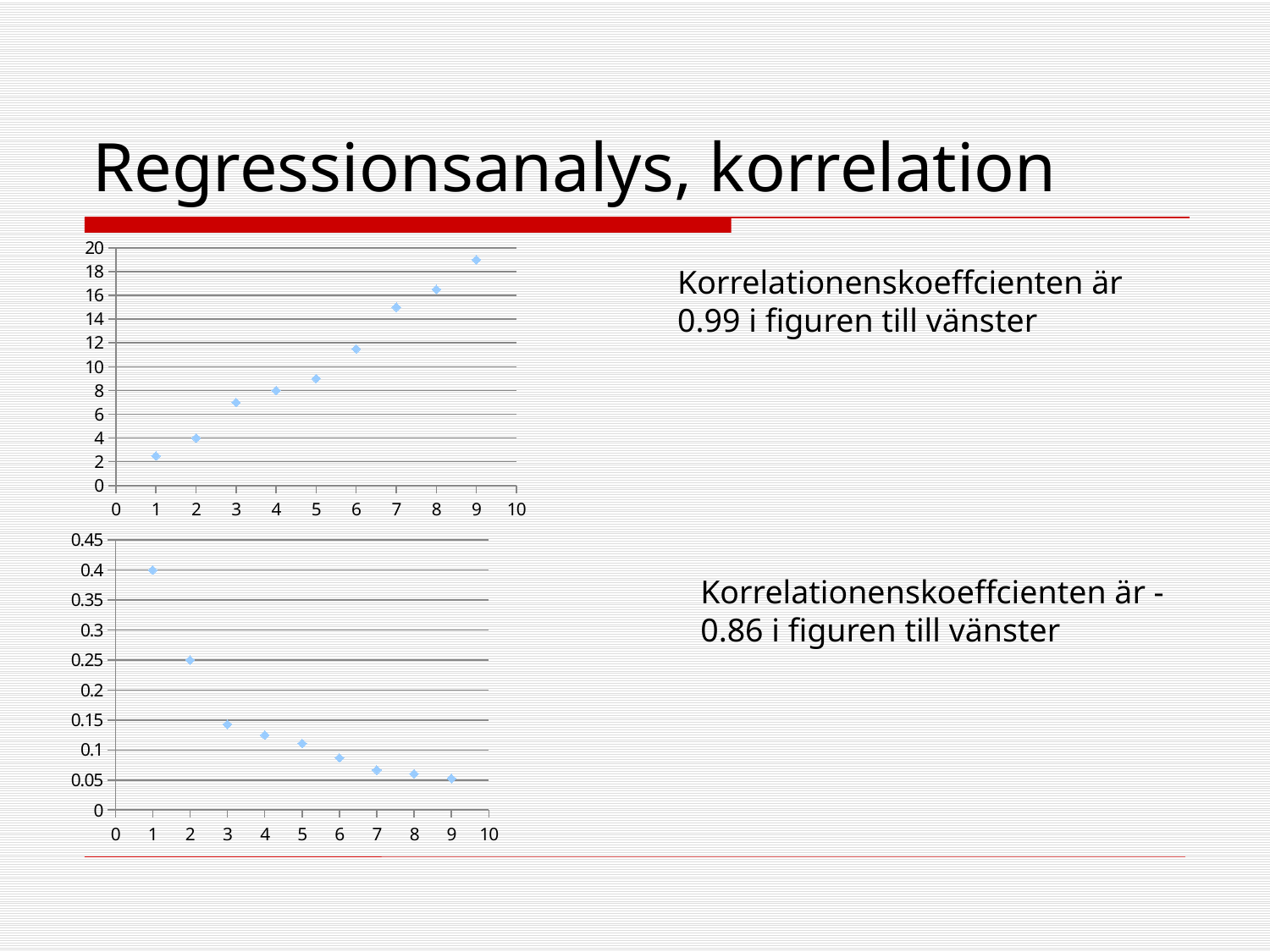
What kind of chart is the top chart on the slide? scatter chart In the top chart, at which x value is the highest point? 9 In the top chart, is the value at x = 9 greater or less than 18? greater In the top chart, at which x value is the lowest point? 1 How many data points are plotted in the bottom chart? 9 In the bottom chart, do the values rise or fall as x increases? fall In the top chart, is the value at x = 6 greater or less than 10? greater How many data points are plotted in the top chart? 9 In the bottom chart, is the value at x = 6 greater or less than 0.1? less In the top chart, which is larger, the value at x = 7 or the value at x = 3? x = 7 In the bottom chart, at which x value is the highest point? 1 In the top chart, do the values rise or fall as x increases? rise